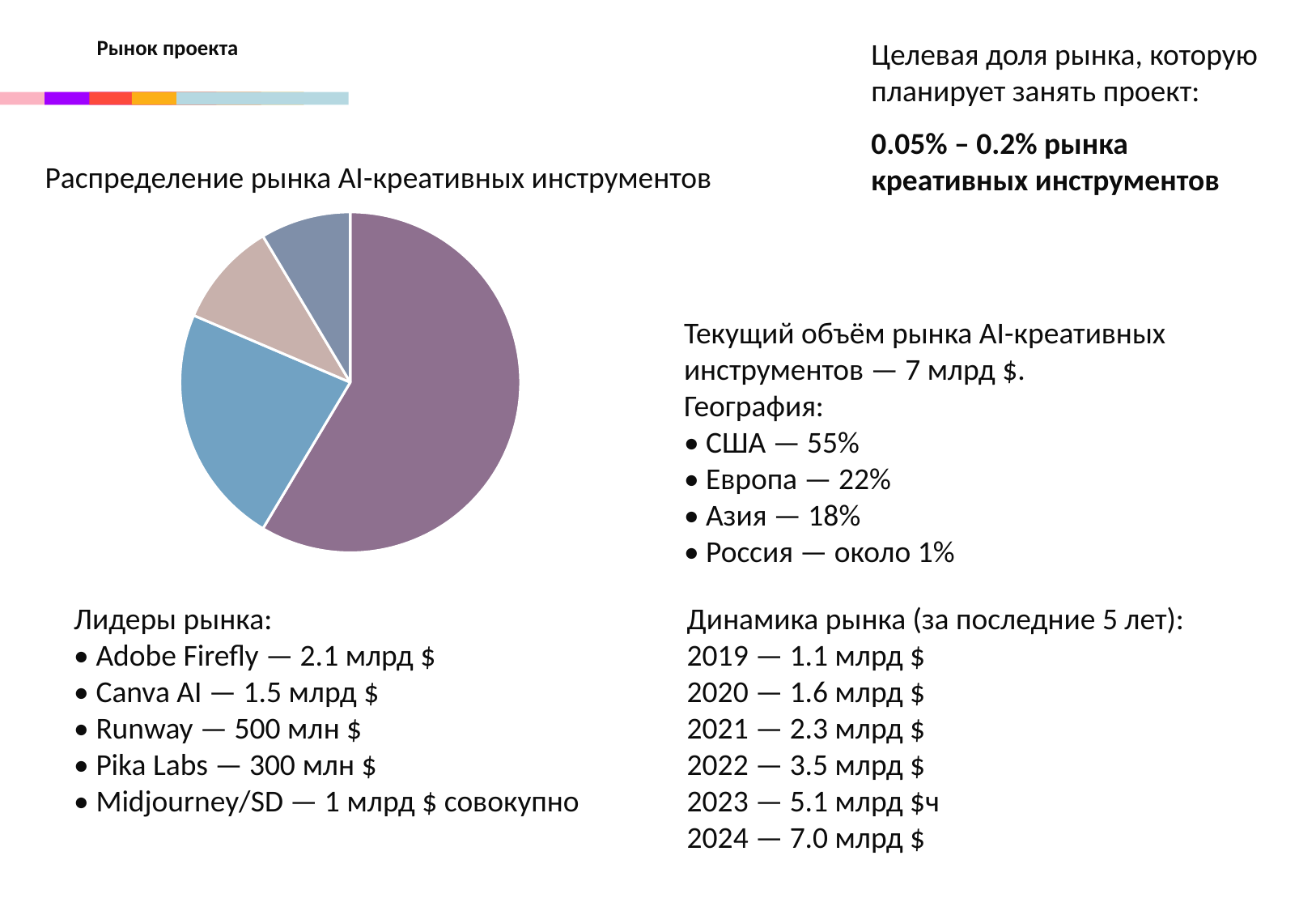
How many slices does the pie chart have? 4 Which is larger in the pie chart, the purple slice or the blue slice? purple Does the pie chart have a legend? no Which colour slice is the largest in the pie chart? purple Does the purple slice take up more or less than half of the pie chart? more What kind of chart is shown on the slide? pie chart Which is larger in the pie chart, the blue slice or the beige slice? blue What is the title of the pie chart? Распределение рынка AI-креативных инструментов